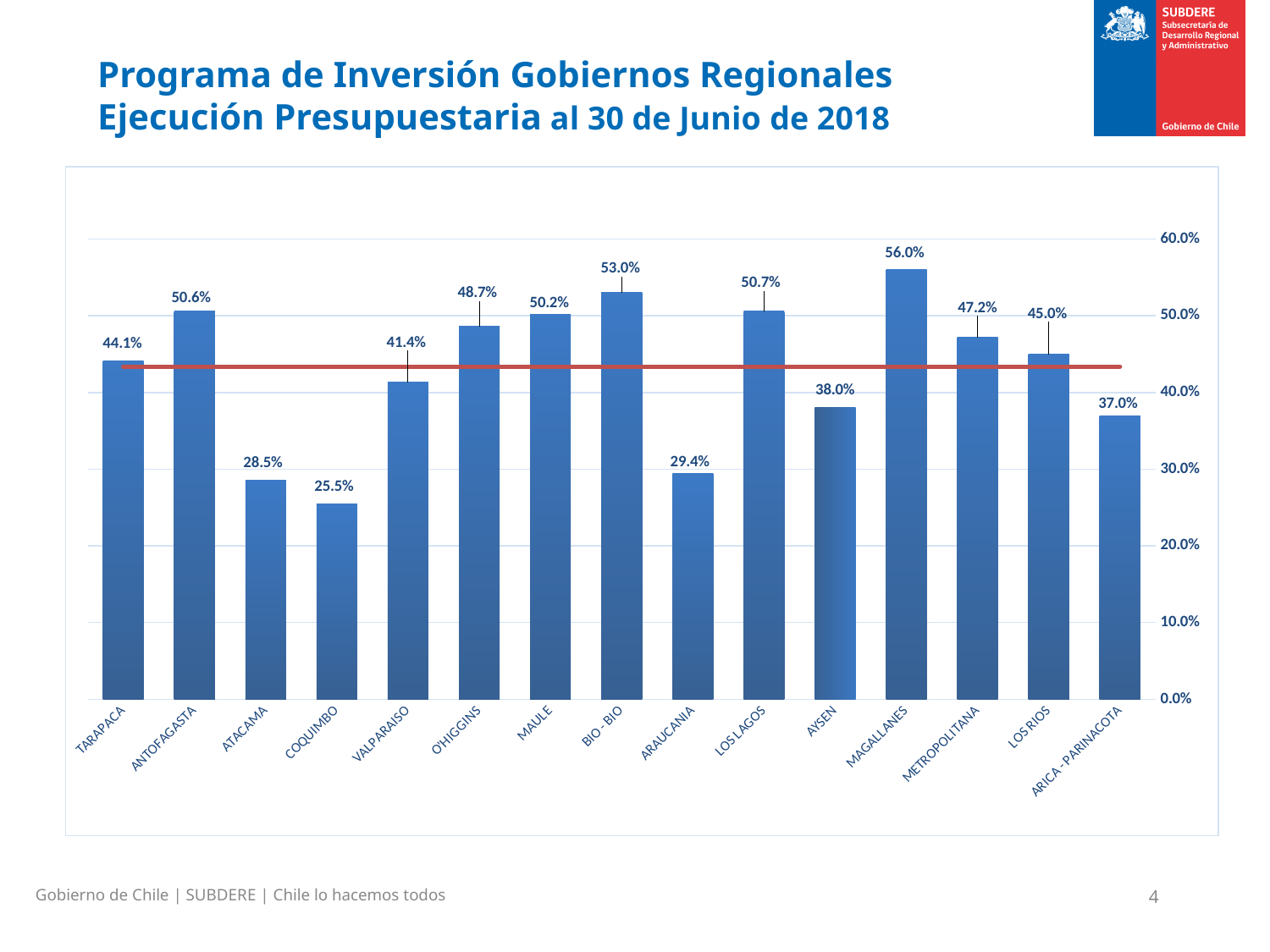
Which region has the lowest value? COQUIMBO What is the value for ARICA - PARINACOTA? 37.0% What is the value for METROPOLITANA? 47.2% Is the value for ATACAMA greater or less than 30.0%? less What is the value for MAGALLANES? 56.0% Which region has the highest value? MAGALLANES How many regions are shown on the x axis? 15 What is the value for COQUIMBO? 25.5% What is the value for AYSEN? 38.0% What kind of chart is shown on the slide? bar chart What is the difference between the values for BIO - BIO and ARAUCANIA? 23.6% Which is larger, the value for TARAPACA or the value for LOS RIOS? LOS RIOS